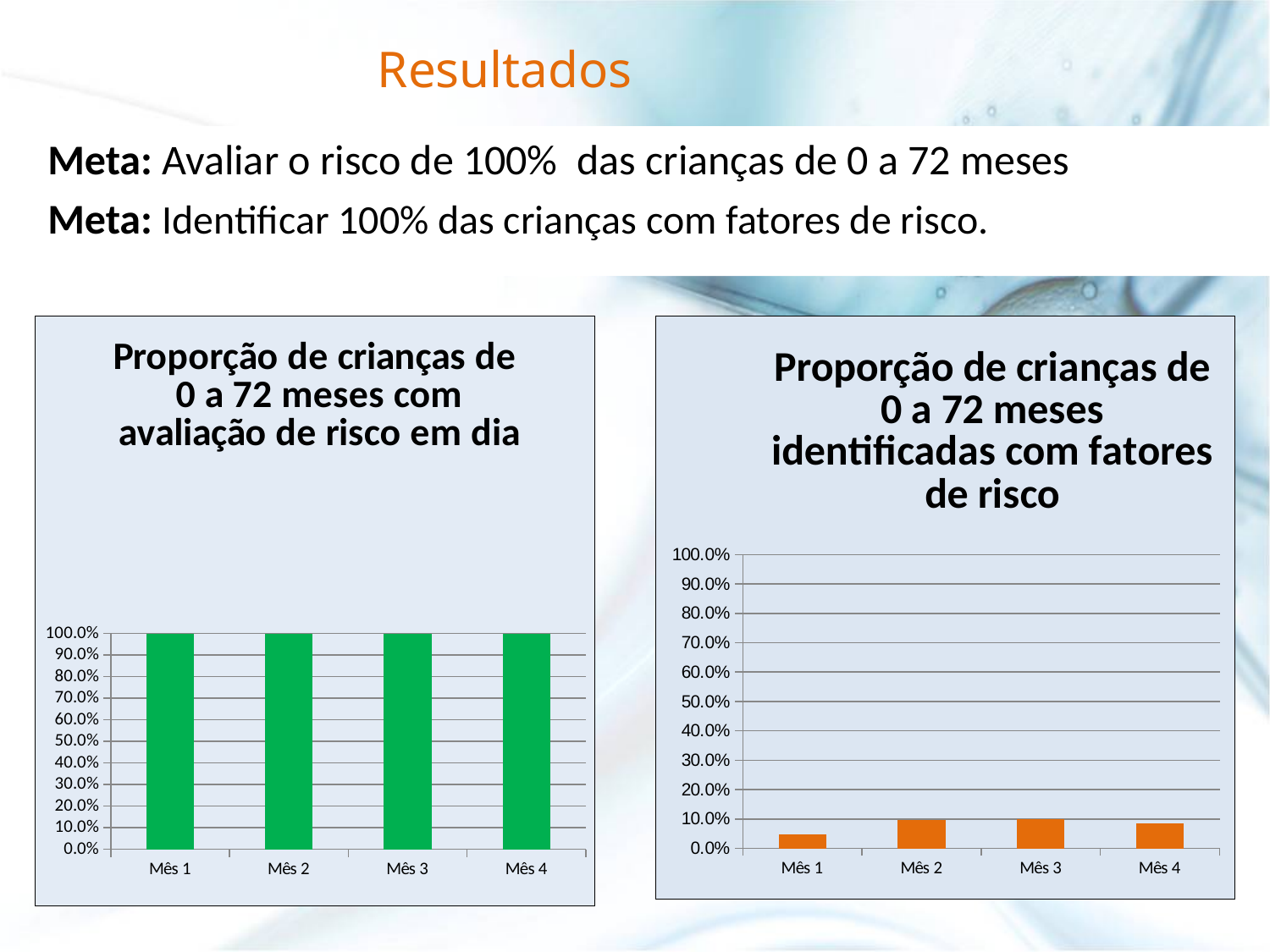
On the right chart (Proporção de crianças de 0 a 72 meses identificadas com fatores de risco), is the value for Mês 3 greater or less than 20.0%? less On the left chart (Proporção de crianças de 0 a 72 meses com avaliação de risco em dia), what is the value for Mês 4? 100.0% On the right chart (Proporção de crianças de 0 a 72 meses identificadas com fatores de risco), is the value for Mês 1 greater or less than 10.0%? less What colour are the bars on the left chart (Proporção de crianças de 0 a 72 meses com avaliação de risco em dia)? green On the left chart (Proporção de crianças de 0 a 72 meses com avaliação de risco em dia), what is the value for Mês 1? 100.0% On the right chart (Proporção de crianças de 0 a 72 meses identificadas com fatores de risco), which month has the lowest value? Mês 1 On the right chart (Proporção de crianças de 0 a 72 meses identificadas com fatores de risco), how many months are plotted? 4 On the left chart (Proporção de crianças de 0 a 72 meses com avaliação de risco em dia), do the values rise, fall or stay the same from Mês 1 to Mês 4? stay the same What colour are the bars on the right chart (Proporção de crianças de 0 a 72 meses identificadas com fatores de risco)? orange On the left chart (Proporção de crianças de 0 a 72 meses com avaliação de risco em dia), how many months are plotted? 4 On the right chart (Proporção de crianças de 0 a 72 meses identificadas com fatores de risco), which is larger, the value for Mês 1 or Mês 2? Mês 2 What kind of chart is the left chart (Proporção de crianças de 0 a 72 meses com avaliação de risco em dia)? bar chart